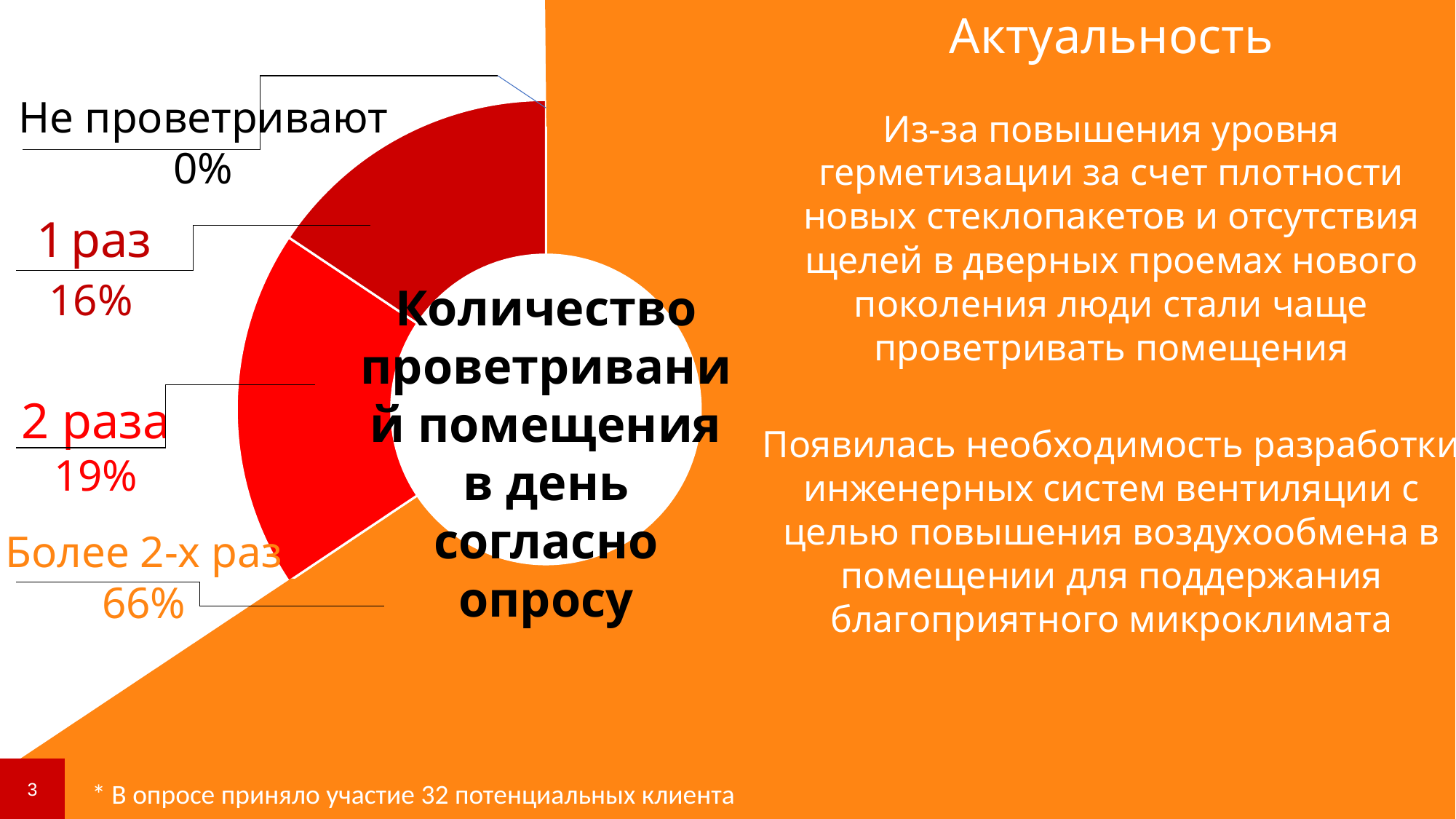
How many categories are shown in the chart? 4 What is the difference in percentage points between the '2 раза' and '1 раз' categories? 3% What is the difference in percentage points between 'Более 2-х раз' and '2 раза'? 47% What percentage of respondents ventilate the room twice a day (2 раза)? 19% What is the title of the chart? Количество проветриваний помещения в день согласно опросу What kind of chart is shown on the slide? Doughnut (pie) chart What percentage of respondents ventilate the room once a day (1 раз)? 16% Which is larger: the share for '1 раз' or the share for '2 раза'? 2 раза Which category has the smallest share in the chart? Не проветривают What percentage of respondents do not ventilate the room (Не проветривают)? 0% Which category has the largest share in the chart? Более 2-х раз What percentage of respondents ventilate the room more than twice a day (Более 2-х раз)? 66%